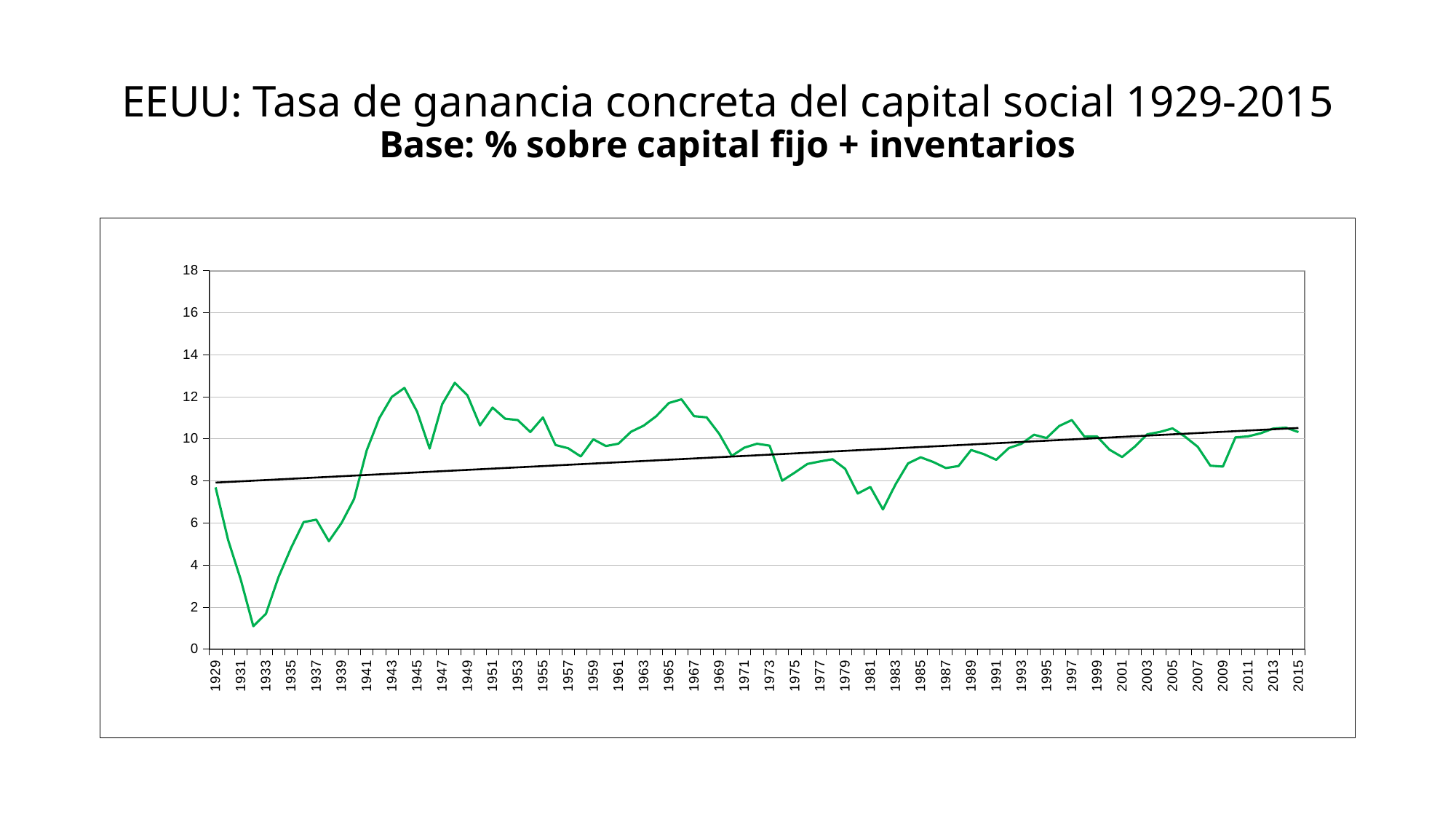
What is the highest value shown on the vertical axis? 18 Does the straight black trend line rise or fall from 1929 to 2015? rise Is the value for 1965 greater or less than 10? greater What kind of chart is shown on the slide? line chart Does the green line rise or fall between 1929 and 1932? fall Which is larger, the value for 1982 or the value for 1965? 1965 Is the value for 2009 greater or less than 10? less Which year has the lowest value on the green line? 1932 Is the value for 1982 greater or less than 8? less Which is larger, the value for 1932 or the value for 1949? 1949